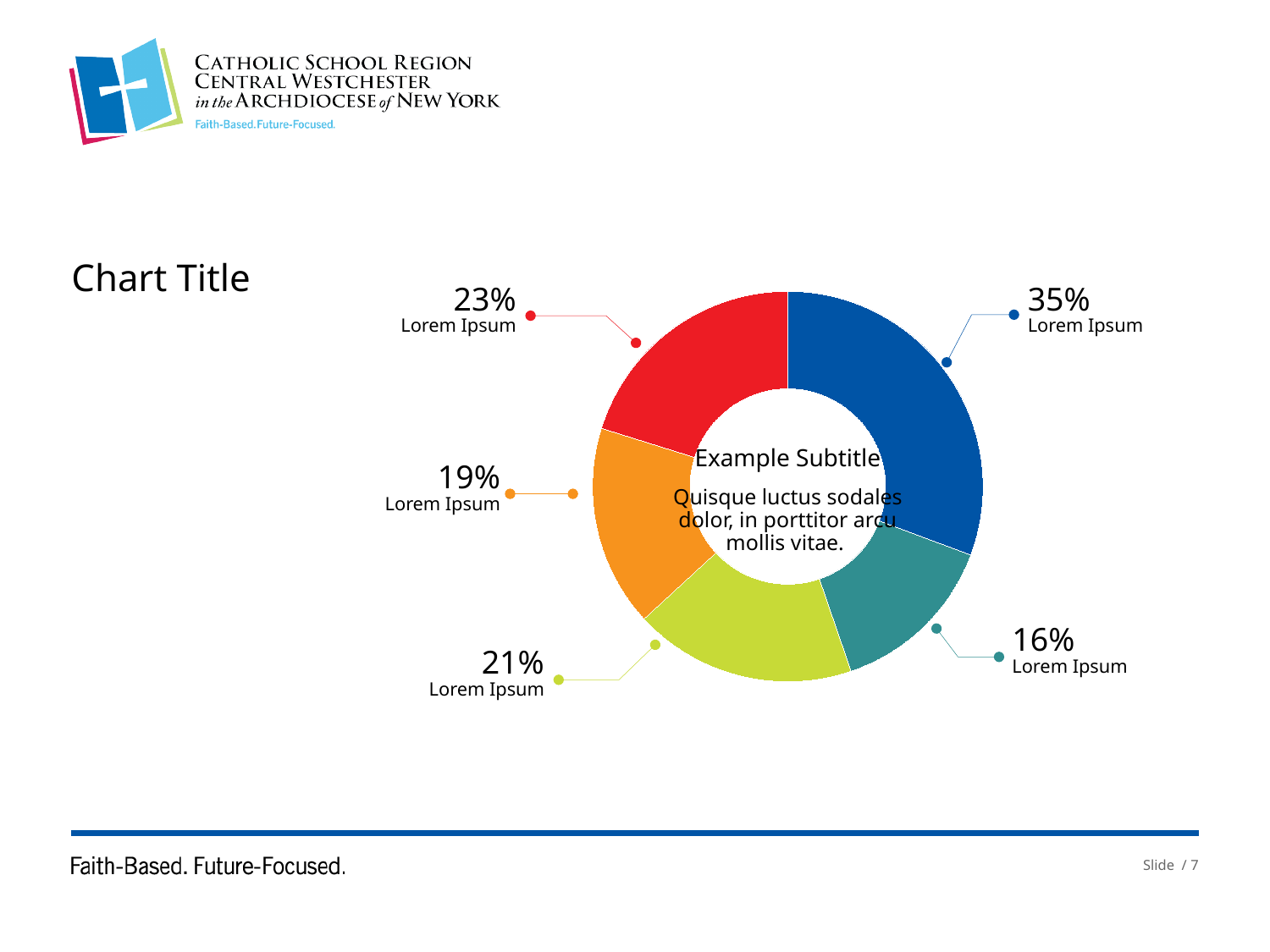
What subtitle text appears in the centre of the donut chart? Example Subtitle What percentage is labelled on the dark blue slice of the pie chart? 35% What percentage is labelled on the teal slice of the pie chart? 16% What is the difference between the largest slice (35%) and the smallest slice (16%)? 19% What percentage is labelled on the orange slice of the pie chart? 19% What is the largest percentage shown on the pie chart? 35% What kind of chart is shown on the slide? Pie chart (donut) Which slice is larger, the red slice or the lime green slice? The red slice (23%) What is the smallest percentage shown on the pie chart? 16% How many slices does the pie chart have? 5 What is the title of the chart? Chart Title What percentage is labelled on the red slice of the pie chart? 23%